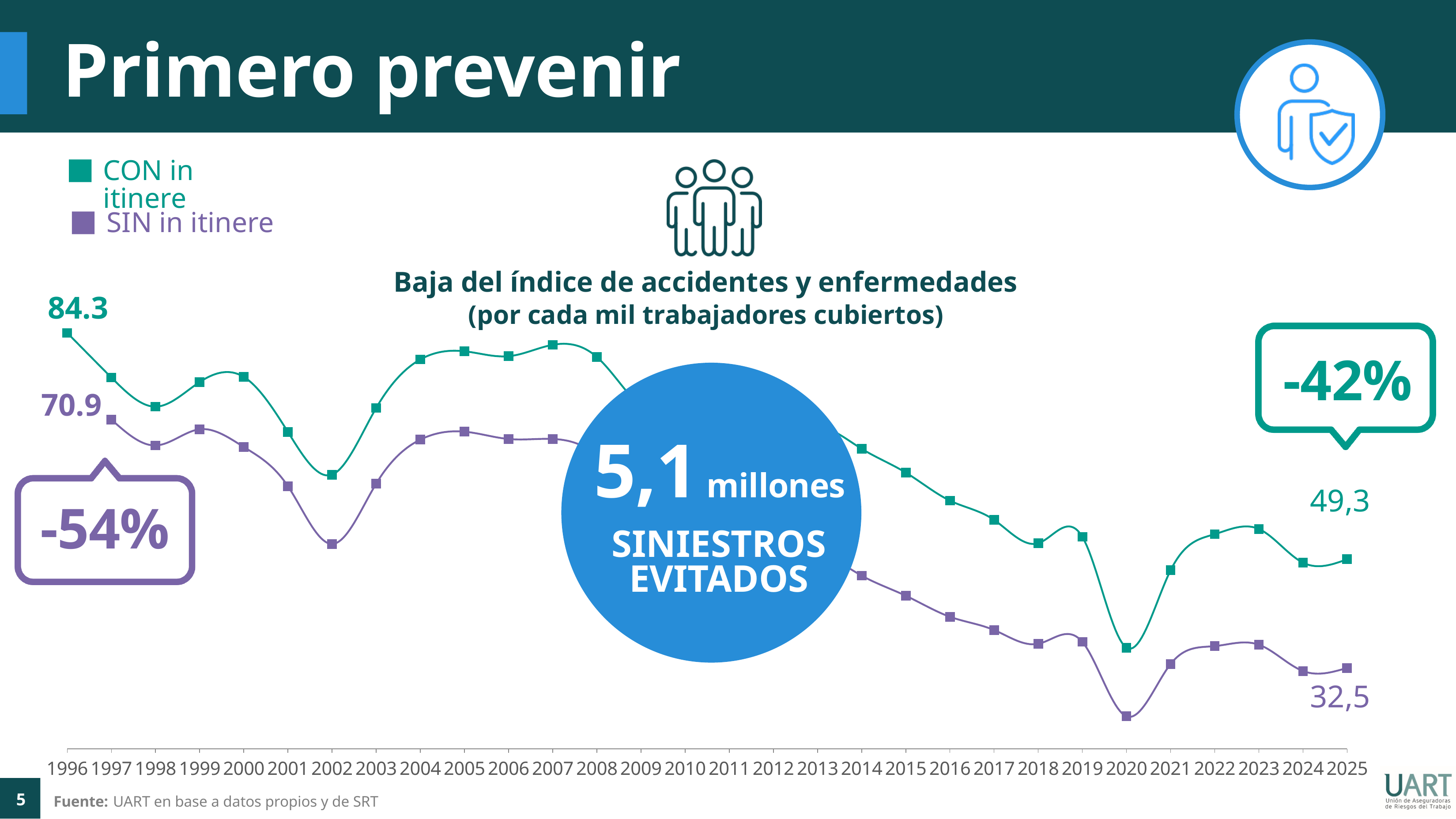
How many series does the legend list? 2 Which series has the higher value in 2025, CON in itinere or SIN in itinere? CON in itinere In which year does the SIN in itinere series reach its lowest point? 2020 What is the value of the SIN in itinere series in 2025? 32,5 How many years are shown on the x axis of the chart? 30 What kind of chart is shown on the slide? Line chart What is the difference between the CON in itinere and SIN in itinere values in 2025? 16,8 What is the value of the CON in itinere series in 1996? 84.3 Do the values of the CON in itinere series rise or fall overall from 1996 to 2025? Fall What is the value of the CON in itinere series in 2025? 49,3